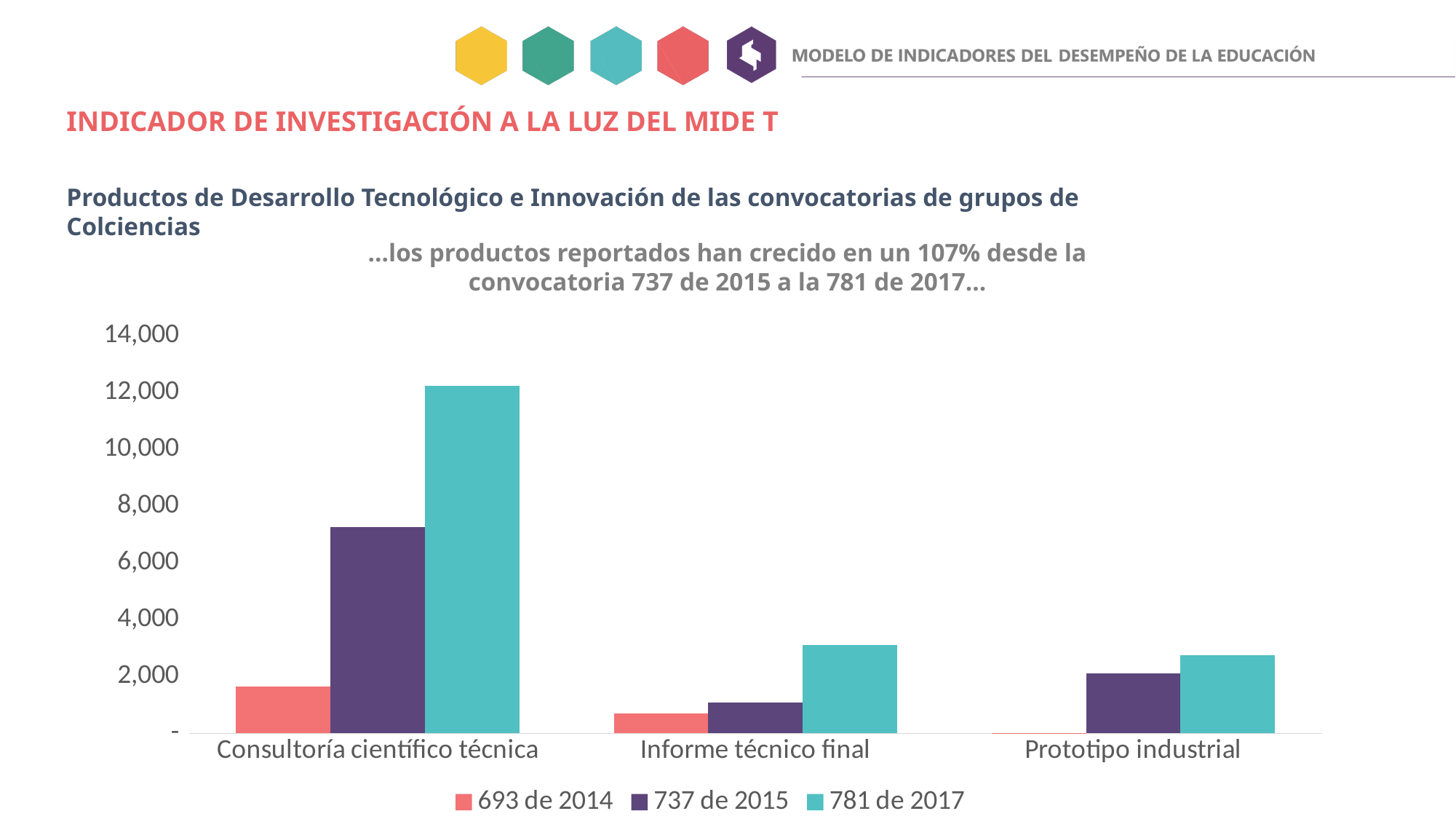
For the 737 de 2015 series, which is larger: Informe técnico final or Prototipo industrial? Prototipo industrial Is the value for 781 de 2017 in Informe técnico final greater or less than 2,000? greater Which category has the tallest bar in the chart? Consultoría científico técnica Is the value for 693 de 2014 in Consultoría científico técnica greater or less than 2,000? less How many series does the chart legend list? 3 How many categories are shown on the x axis of the chart? 3 For Consultoría científico técnica, which series has the highest value? 781 de 2017 Is the value for 737 de 2015 in Consultoría científico técnica greater or less than 6,000? greater For Consultoría científico técnica, do the values rise or fall from the 693 de 2014 series to the 781 de 2017 series? rise For the 781 de 2017 series, which category has the lowest value? Prototipo industrial What kind of chart is shown on the slide? Bar chart